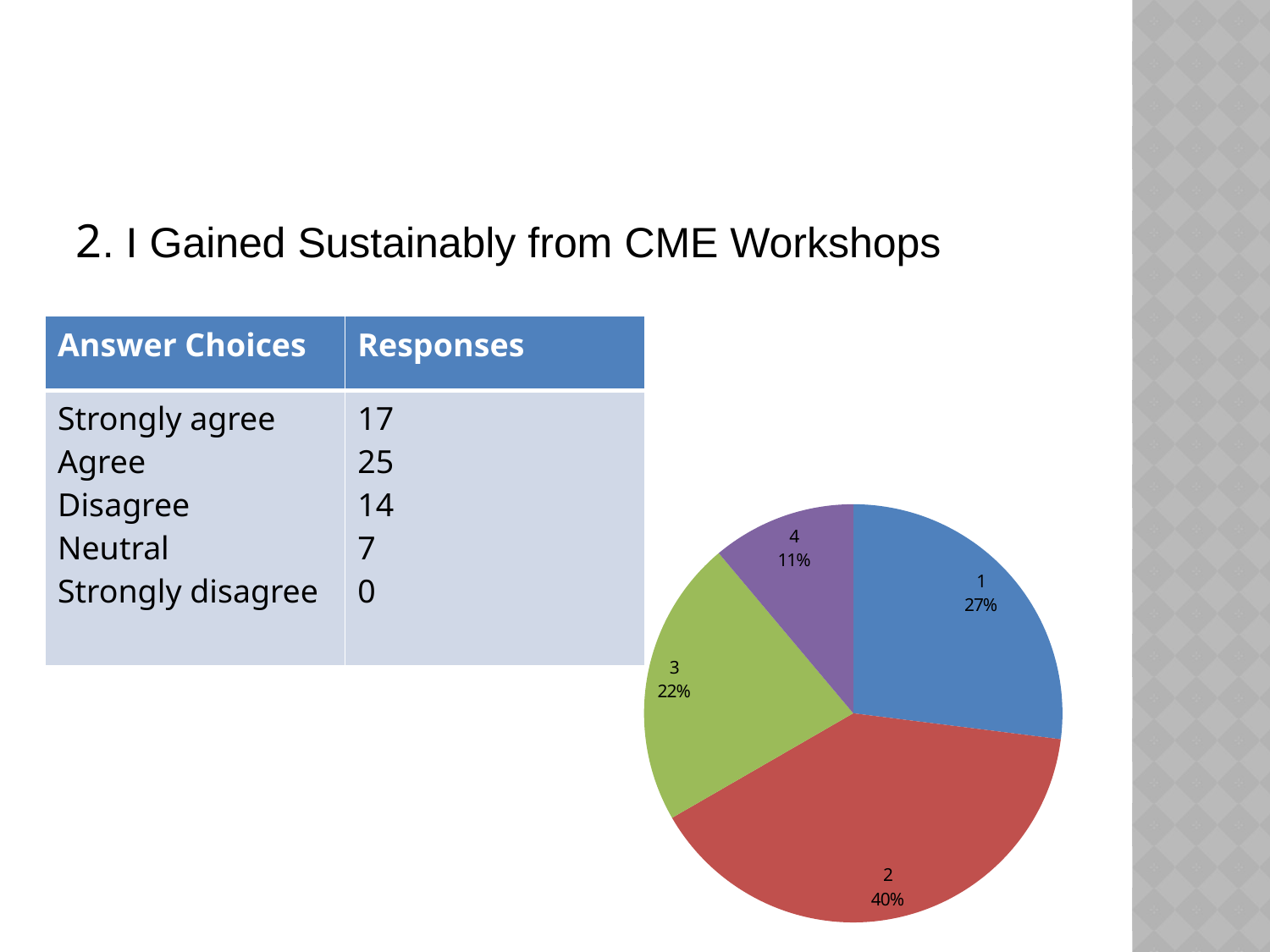
What percentage is shown for slice 2 in the pie chart? 40% Which slice of the pie chart is the largest? 2 What kind of chart is shown on the slide? pie chart What is the difference in percentage points between slice 2 and slice 1 in the pie chart? 13 What colour is slice 2 in the pie chart? red Which slice of the pie chart is the smallest? 4 What percentage is shown for slice 4 in the pie chart? 11% How many slices does the pie chart have? 4 What colour is slice 1 in the pie chart? blue What percentage is shown for slice 3 in the pie chart? 22% Which slice is larger in the pie chart, slice 3 or slice 4? 3 What percentage is shown for slice 1 in the pie chart? 27%